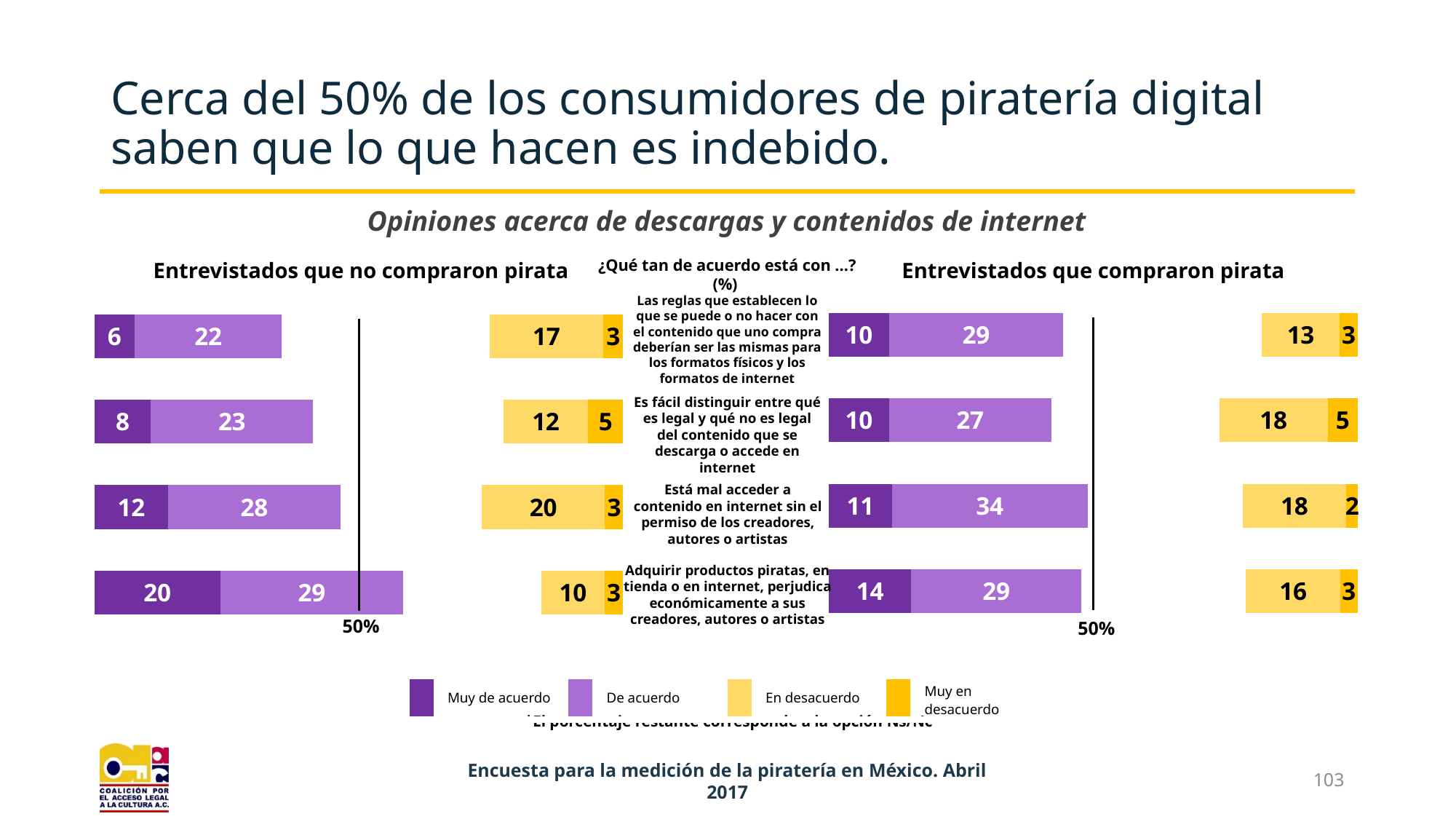
In the 'Entrevistados que no compraron pirata' chart, what is the combined 'Muy de acuerdo' plus 'De acuerdo' total for 'Está mal acceder a contenido en internet sin el permiso de los creadores, autores o artistas'? 40 How many statements are shown in the 'Entrevistados que no compraron pirata' chart? 4 Which legend entry is shown in dark purple? Muy de acuerdo In the 'Entrevistados que compraron pirata' chart, what is the 'En desacuerdo' value for 'Es fácil distinguir entre qué es legal y qué no es legal del contenido que se descarga o accede en internet'? 18 In the 'Entrevistados que no compraron pirata' chart, which statement has the highest 'Muy de acuerdo' value? Adquirir productos piratas, en tienda o en internet, perjudica económicamente a sus creadores, autores o artistas What kind of chart is 'Entrevistados que compraron pirata'? Bar chart How many series does the legend list? 4 In the 'Entrevistados que no compraron pirata' chart, what is the 'Muy de acuerdo' value for 'Adquirir productos piratas, en tienda o en internet, perjudica económicamente a sus creadores, autores o artistas'? 20 In the 'Entrevistados que compraron pirata' chart, which statement has the lowest 'Muy en desacuerdo' value? Está mal acceder a contenido en internet sin el permiso de los creadores, autores o artistas Which is larger: the 'Muy de acuerdo' value for 'Las reglas que establecen lo que se puede o no hacer con el contenido que uno compra deberían ser las mismas para los formatos físicos y los formatos de internet' in the 'Entrevistados que no compraron pirata' chart or in the 'Entrevistados que compraron pirata' chart? Entrevistados que compraron pirata In the 'Entrevistados que compraron pirata' chart, what is the 'De acuerdo' value for 'Está mal acceder a contenido en internet sin el permiso de los creadores, autores o artistas'? 34 In the 'Entrevistados que compraron pirata' chart, what is the difference between the 'De acuerdo' values for 'Está mal acceder a contenido en internet sin el permiso de los creadores, autores o artistas' and 'Es fácil distinguir entre qué es legal y qué no es legal del contenido que se descarga o accede en internet'? 7